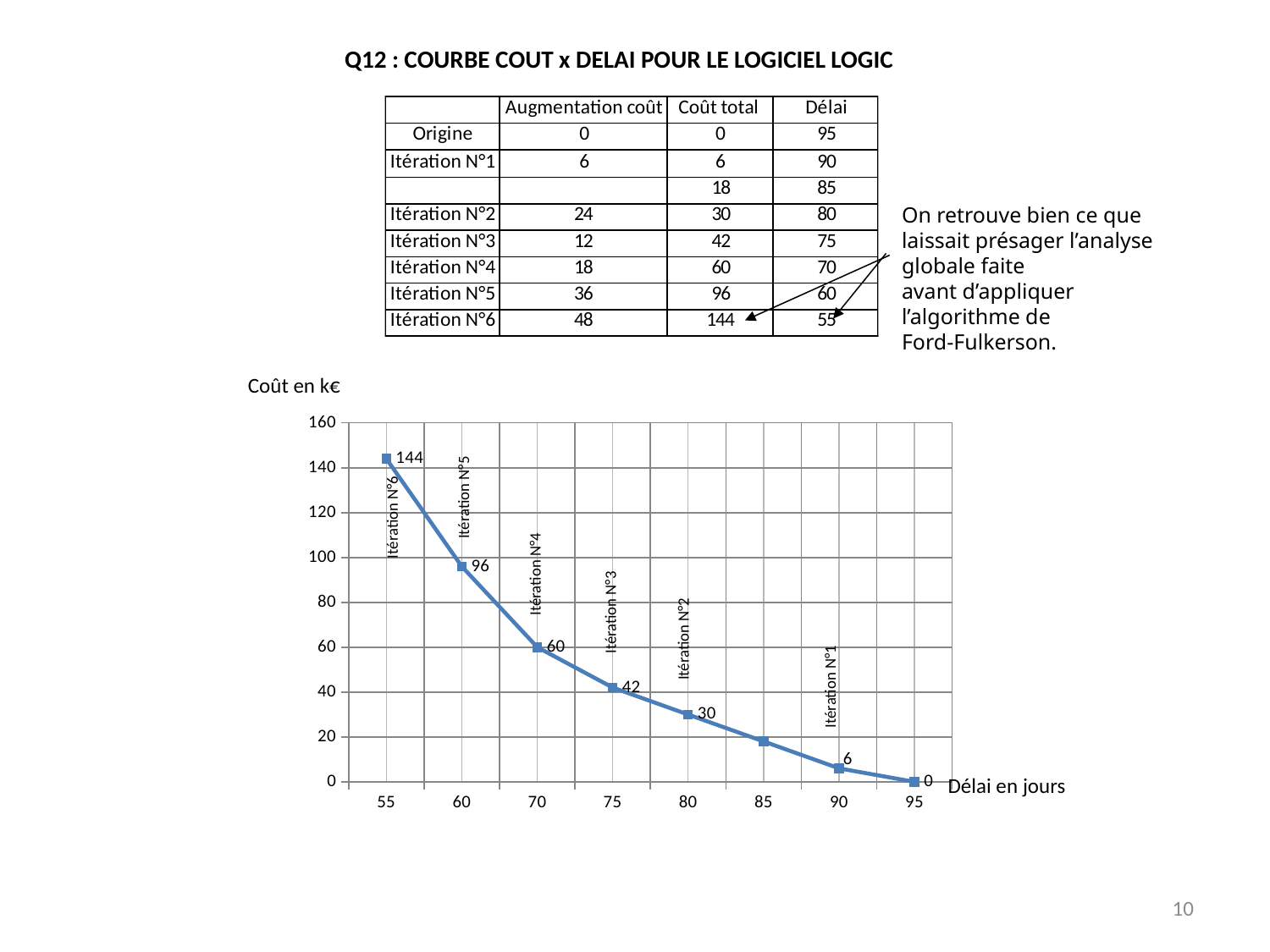
What type of chart is shown on the slide? line chart What is the cost plotted at a delay of 80 days? 30 What is the difference between the cost at 55 days and the cost at 60 days? 48 How many data points are plotted on the line? 8 Which has a higher cost: the point at 75 days or the point at 90 days? 75 days What is the cost plotted at a delay of 60 days? 96 Does the cost rise or fall as the delay increases along the x axis? fall What is the cost (Coût en k€) plotted at a delay of 55 days? 144 At which delay (in days) is the plotted cost highest? 55 At which delay (in days) is the plotted cost lowest? 95 What is the cost plotted at a delay of 70 days? 60